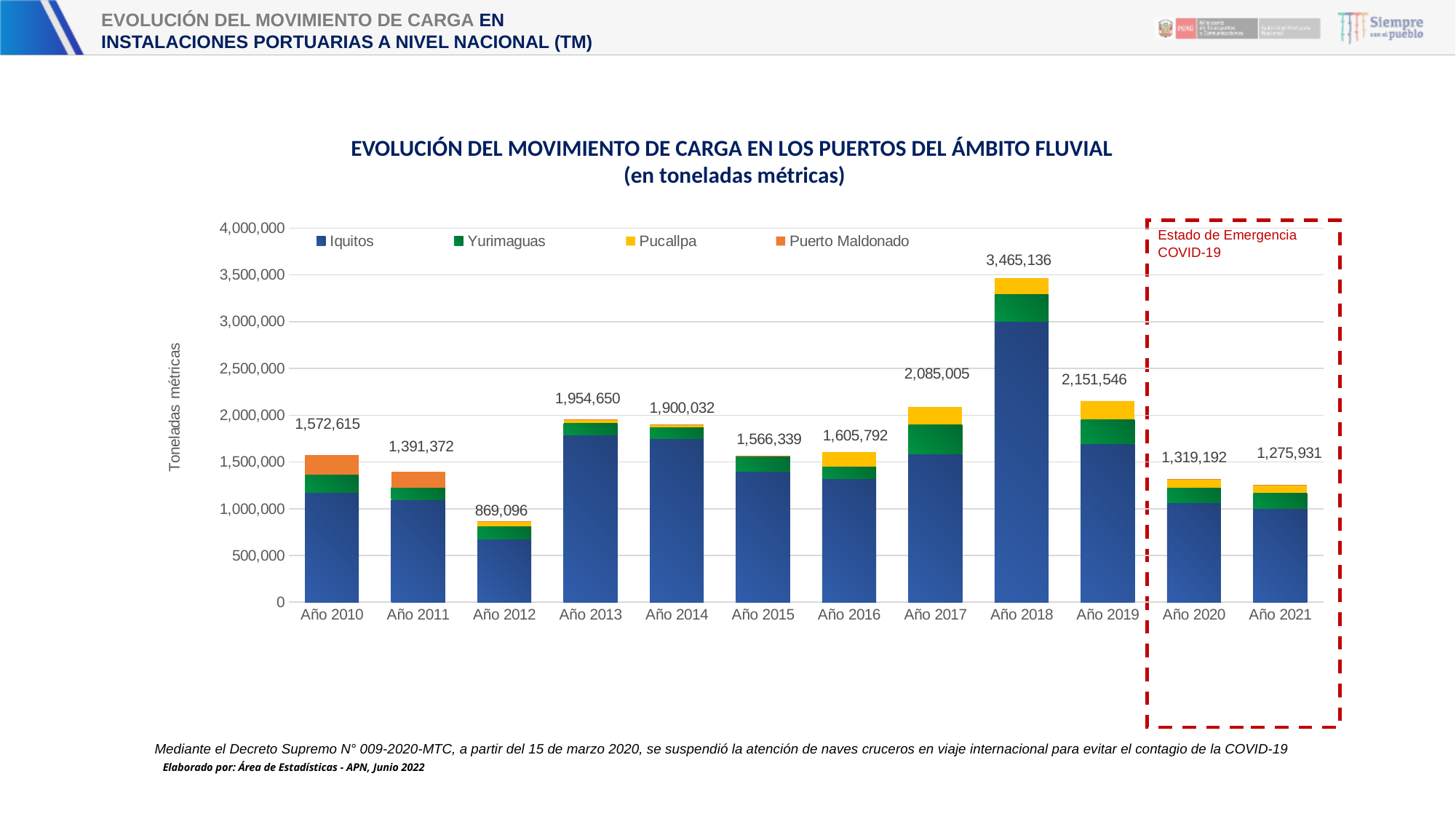
Which year has a larger total, Año 2013 or Año 2014? Año 2013 Is the Iquitos value for Año 2018 greater or less than 2,500,000? greater How many series does the legend list? 4 Which year has the highest total cargo movement? Año 2018 What is the difference between the total for Año 2020 and the total for Año 2021? 43,261 What is the total cargo movement labeled for Año 2012? 869,096 What is the difference between the total for Año 2019 and the total for Año 2020? 832,354 What is the total cargo movement labeled for Año 2018? 3,465,136 Do the total values rise or fall from Año 2018 to Año 2021? Fall How many years are shown on the x axis? 12 What kind of chart is shown on the slide? Stacked bar chart Which year has the lowest total cargo movement? Año 2012